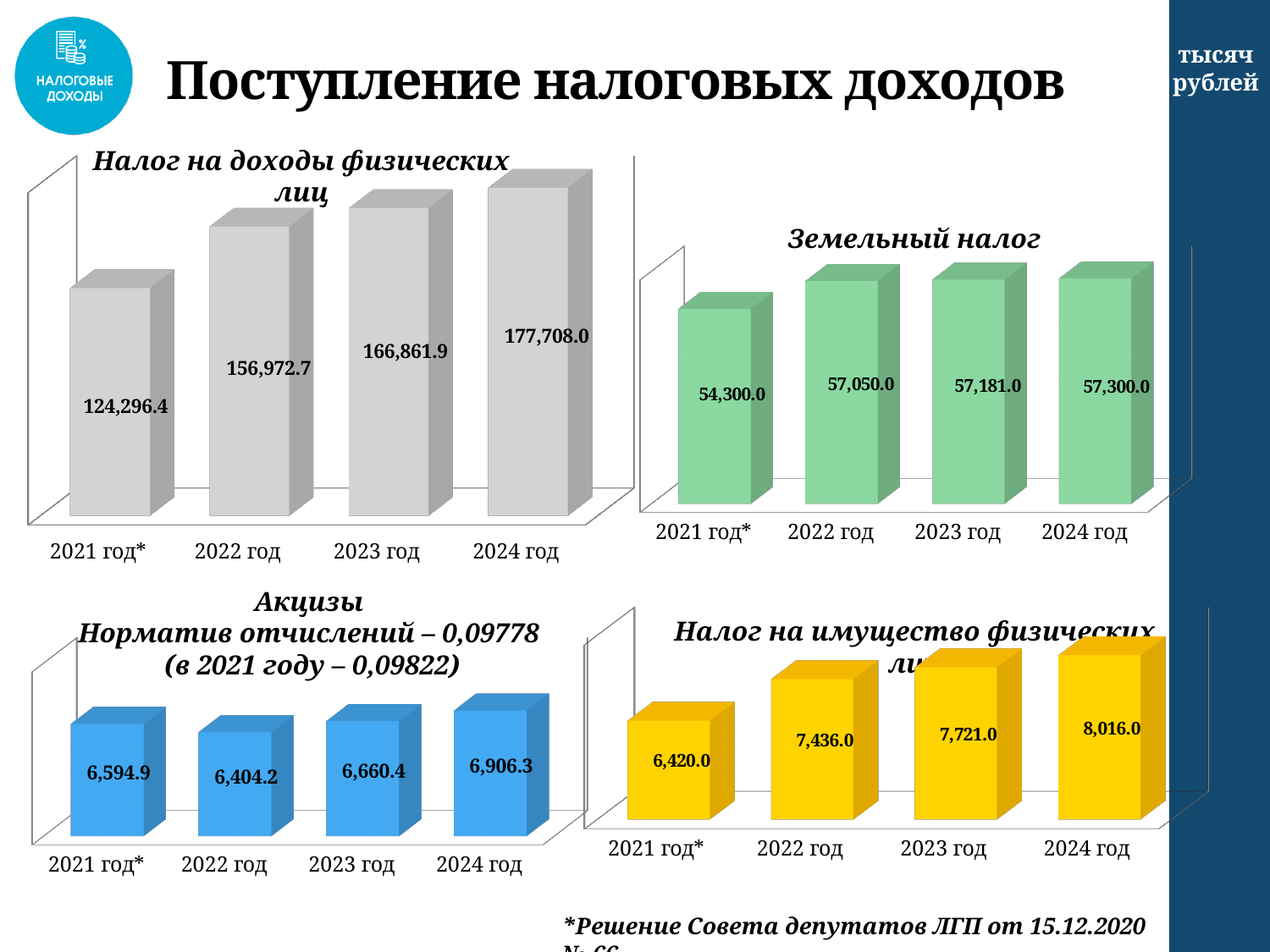
In the chart titled "Земельный налог", what is the value for 2022 год? 57,050.0 In the chart titled "Налог на доходы физических лиц", which year has the highest value? 2024 год In the chart titled "Налог на доходы физических лиц", what is the difference between the values for 2024 год and 2021 год*? 53,411.6 In the chart titled "Земельный налог", what is the difference between the values for 2024 год and 2021 год*? 3,000.0 In the chart titled "Налог на доходы физических лиц", what is the value for 2024 год? 177,708.0 How many years are shown in the chart titled "Акцизы"? 4 In the chart titled "Налог на имущество физических лиц", which is larger: the value for 2022 год or the value for 2021 год*? 2022 год What kind of chart is the chart titled "Земельный налог"? bar chart In the chart titled "Налог на имущество физических лиц", do the values rise or fall from 2021 год* to 2024 год? rise In the chart titled "Акцизы", which year has the lowest value? 2022 год In the chart titled "Налог на имущество физических лиц", what is the value for 2023 год? 7,721.0 In the chart titled "Акцизы", what is the value for 2021 год*? 6,594.9